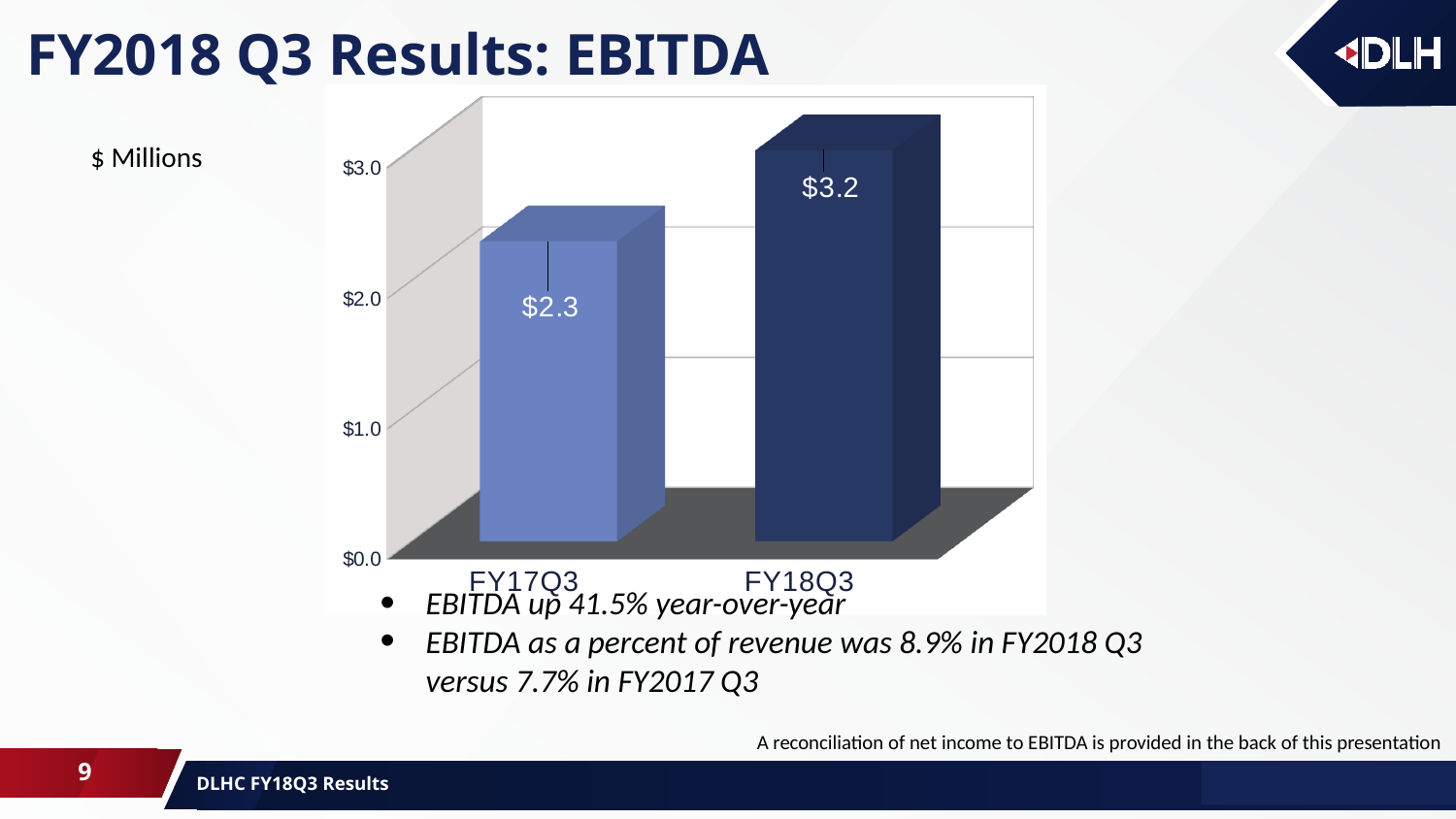
What is the difference between the FY18Q3 and FY17Q3 EBITDA values? $0.9 What is the EBITDA value for FY17Q3? $2.3 What is the EBITDA value for FY18Q3? $3.2 Which quarter has the lower EBITDA? FY17Q3 What unit is indicated for the values in the chart? $ Millions What kind of chart is shown on the slide? bar chart Which quarter has the higher EBITDA? FY18Q3 Is the value for FY18Q3 greater or less than $3.0? greater Is the EBITDA for FY18Q3 larger or smaller than for FY17Q3? larger Do the EBITDA values rise or fall from FY17Q3 to FY18Q3? rise Is the value for FY17Q3 greater or less than $2.0? greater How many categories are shown on the x axis of the chart? 2